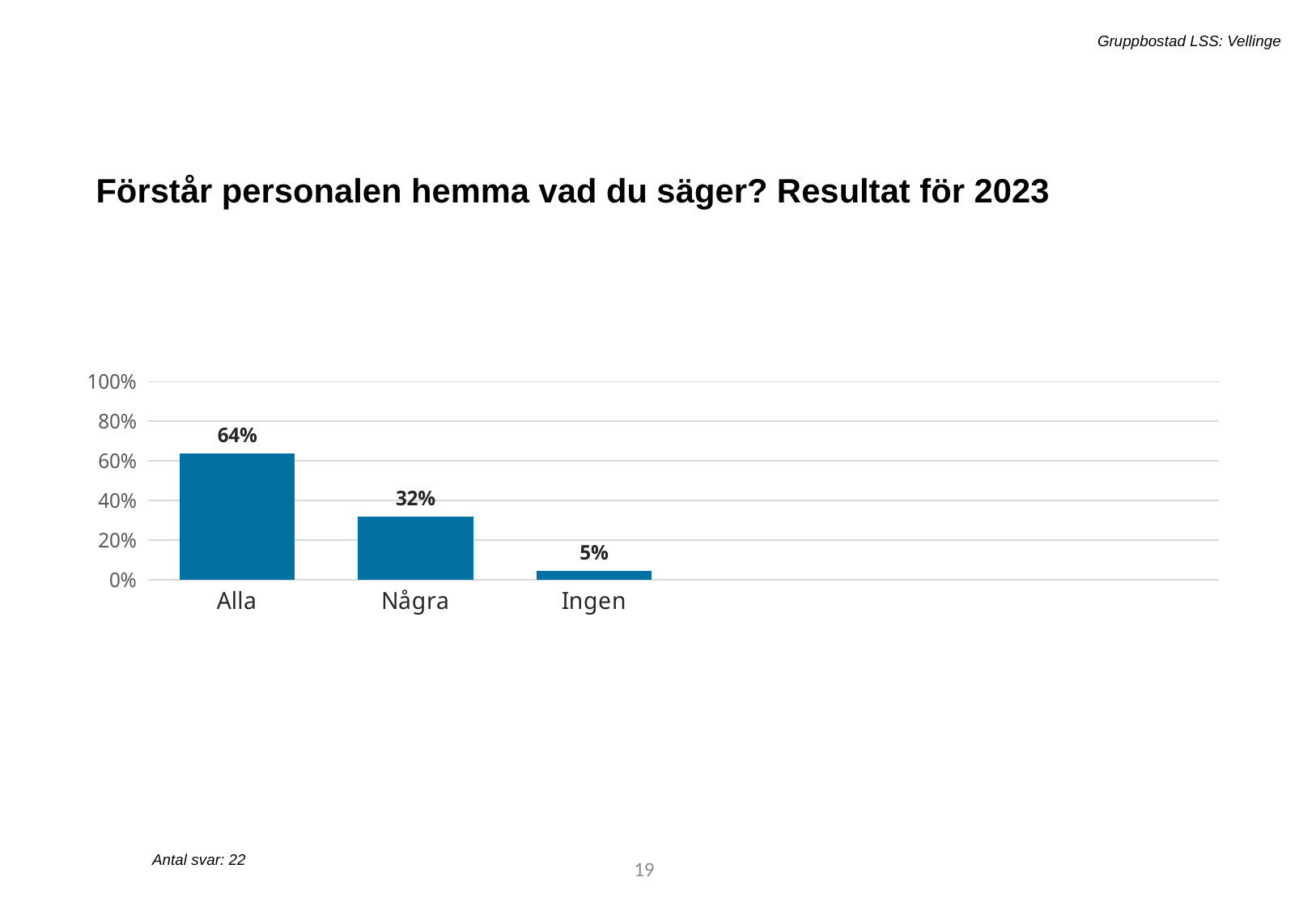
Which is larger, the value for Några or the value for Ingen? Några What is the difference between the values for Alla and Några? 32% What kind of chart is shown on the slide? bar chart What is the value for Alla? 64% Which category has the lowest value? Ingen How many categories are shown on the x axis? 3 Is the value for Alla greater or less than 60%? greater What is the value for Några? 32% What is the value for Ingen? 5% What is the difference between the values for Några and Ingen? 27% What is the title of the chart? Förstår personalen hemma vad du säger? Resultat för 2023 Which category has the highest value? Alla